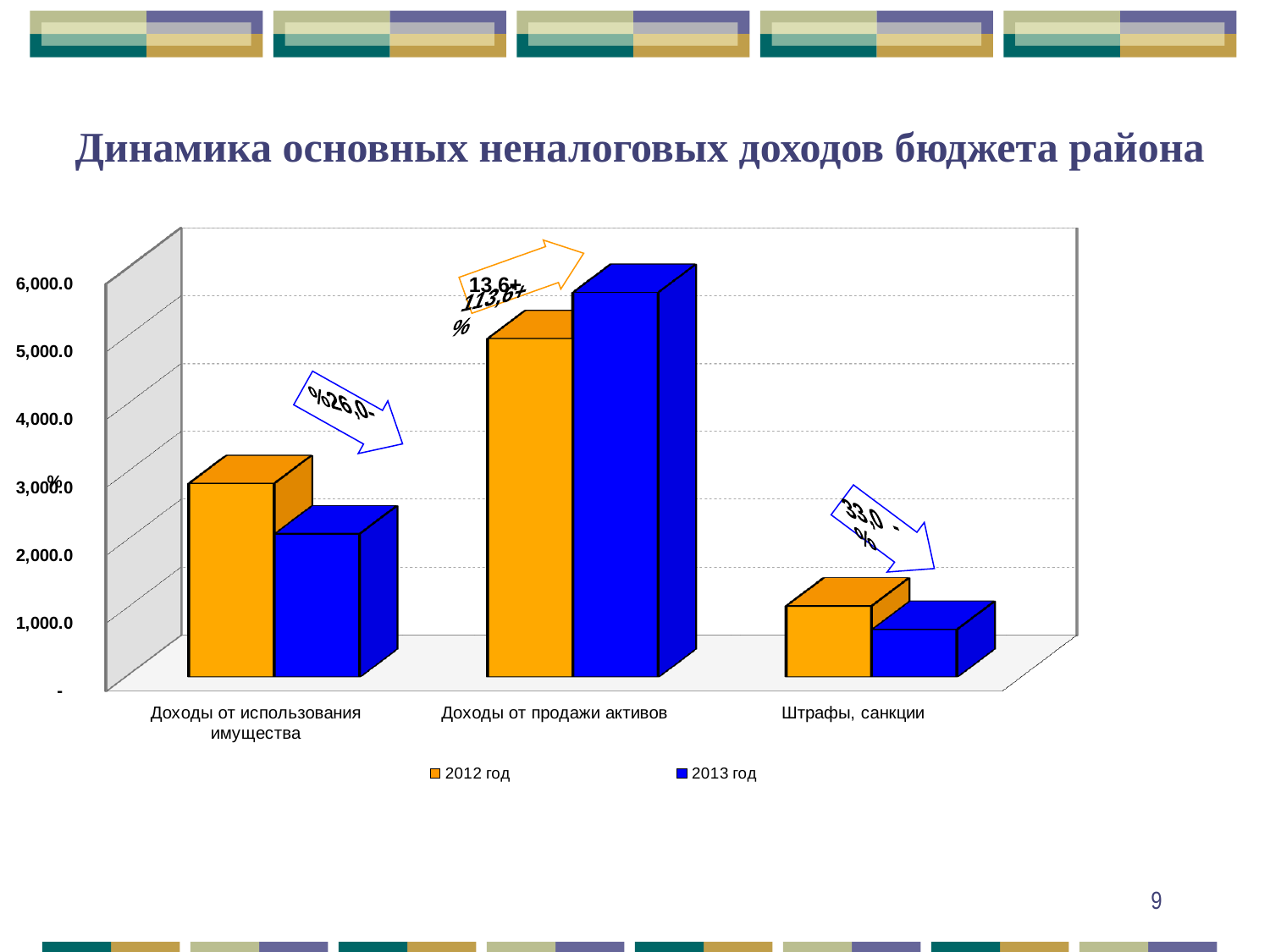
Which category has the lowest value for 2012 год? Штрафы, санкции What is the title of the chart? Динамика основных неналоговых доходов бюджета района How many series does the legend list? 2 What kind of chart is shown on the slide? bar chart Is the value for 2013 год in Штрафы, санкции greater or less than 2,000.0? less How many categories are shown on the x axis? 3 For Доходы от продажи активов, which series is larger: 2012 год or 2013 год? 2013 год For Доходы от использования имущества, which series is larger: 2012 год or 2013 год? 2012 год Is the value for 2012 год in Доходы от использования имущества greater or less than 4,000.0? less Is the value for 2013 год in Доходы от продажи активов greater or less than 5,000.0? greater Which category has the highest value for 2013 год? Доходы от продажи активов Which colour represents the 2013 год series in the legend? blue